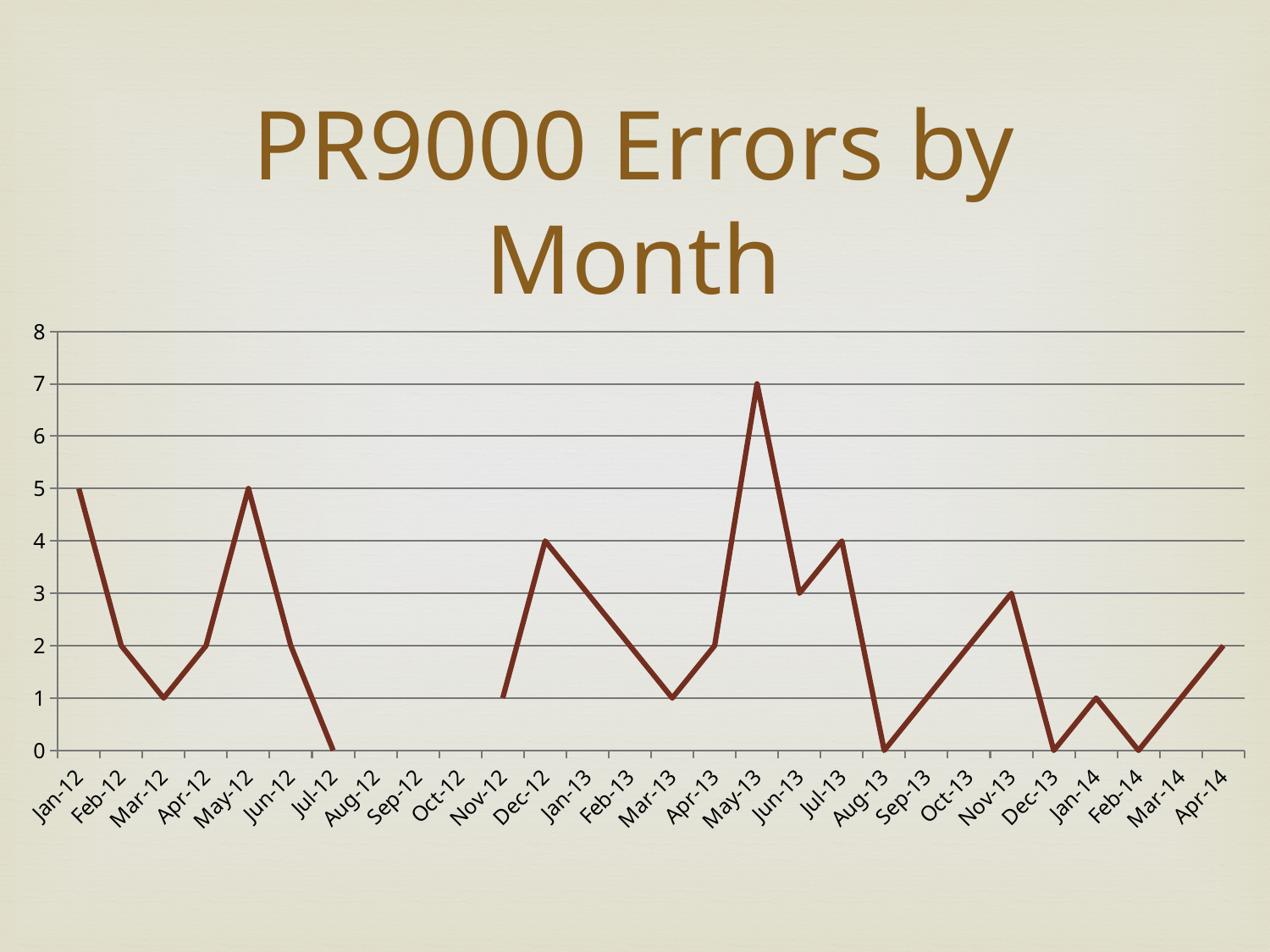
What is the difference in errors between May-13 and Jan-12? 2 How many errors were recorded in Dec-12? 4 How many months are shown on the x axis? 28 Is the value for May-13 greater or less than 6? greater Which month has more errors, Jan-12 or Dec-12? Jan-12 How many errors were recorded in Jan-12? 5 How many errors were recorded in May-13? 7 Do the errors rise or fall from Jan-12 to Mar-12? fall How many errors were recorded in Jul-12? 0 What kind of chart is shown on the slide? line chart What is the title of the chart? PR9000 Errors by Month Which month has the highest number of errors? May-13